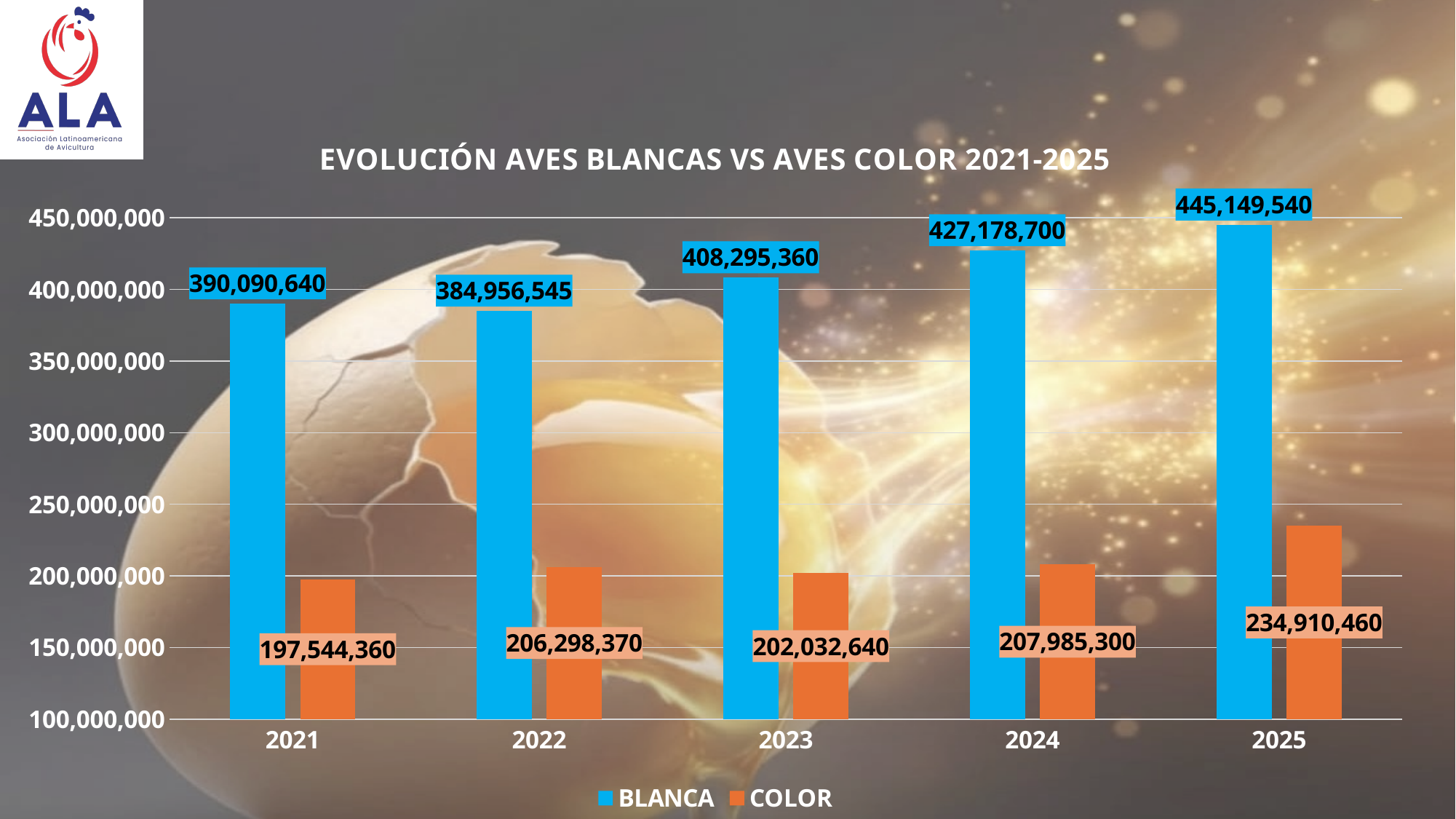
What is the BLANCA value for 2023? 408,295,360 What is the COLOR value for 2024? 207,985,300 By how much did the BLANCA value increase from 2021 to 2025? 55,058,900 What is the difference between the BLANCA and COLOR values in 2025? 210,239,080 In which year is the BLANCA value highest? 2025 Is the COLOR value for 2025 greater or less than 200,000,000? greater What kind of chart is shown on the slide? bar chart In which year is the BLANCA value lowest? 2022 How many series does the legend list? 2 In which year is the COLOR value lowest? 2021 How many years are shown on the x axis? 5 Which is larger, the COLOR value for 2022 or for 2023? 2022